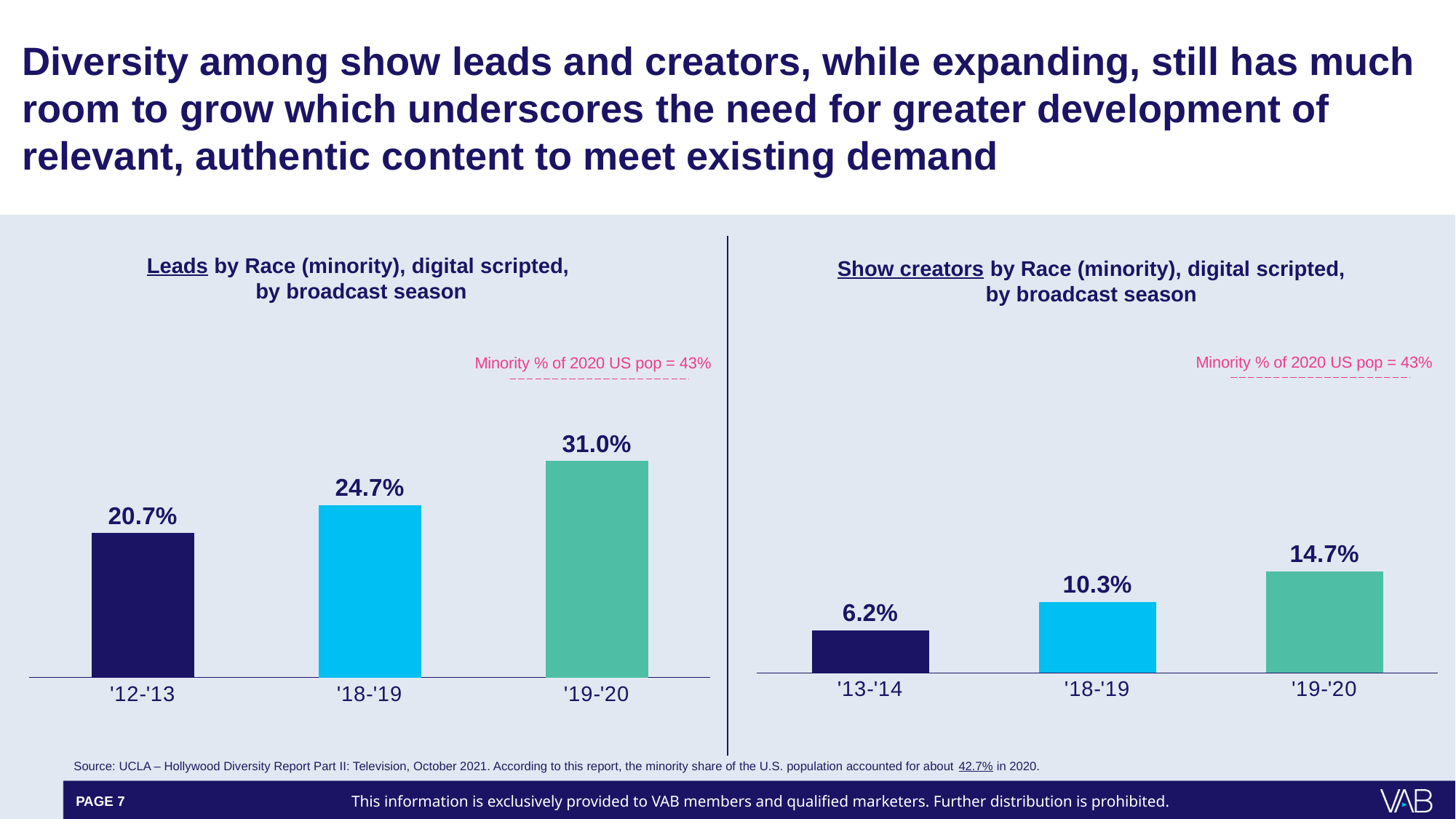
In the 'Leads by Race (minority)' chart on the left, which season has the lowest value? '12-'13 In the 'Leads by Race (minority)' chart on the left, what is the value for '19-'20? 31.0% In the 'Leads by Race (minority)' chart on the left, what is the value for '12-'13? 20.7% What kind of chart is the 'Leads by Race (minority)' chart on the left? Bar chart In the 'Leads by Race (minority)' chart on the left, what is the difference between the '19-'20 and '18-'19 values? 6.3% In the 'Show creators by Race (minority)' chart on the right, do the values rise or fall from '13-'14 to '19-'20? Rise What minority percentage of the 2020 US population is marked by the dashed reference line on both charts? 43% In the 'Show creators by Race (minority)' chart on the right, which season has the highest value? '19-'20 Which is larger: the '18-'19 value in the Leads chart on the left or the '18-'19 value in the Show creators chart on the right? Leads chart ('18-'19, 24.7%) In the 'Show creators by Race (minority)' chart on the right, what is the difference between the '19-'20 and '13-'14 values? 8.5% In the 'Show creators by Race (minority)' chart on the right, what is the value for '13-'14? 6.2% How many seasons are shown in the 'Show creators by Race (minority)' chart on the right? 3